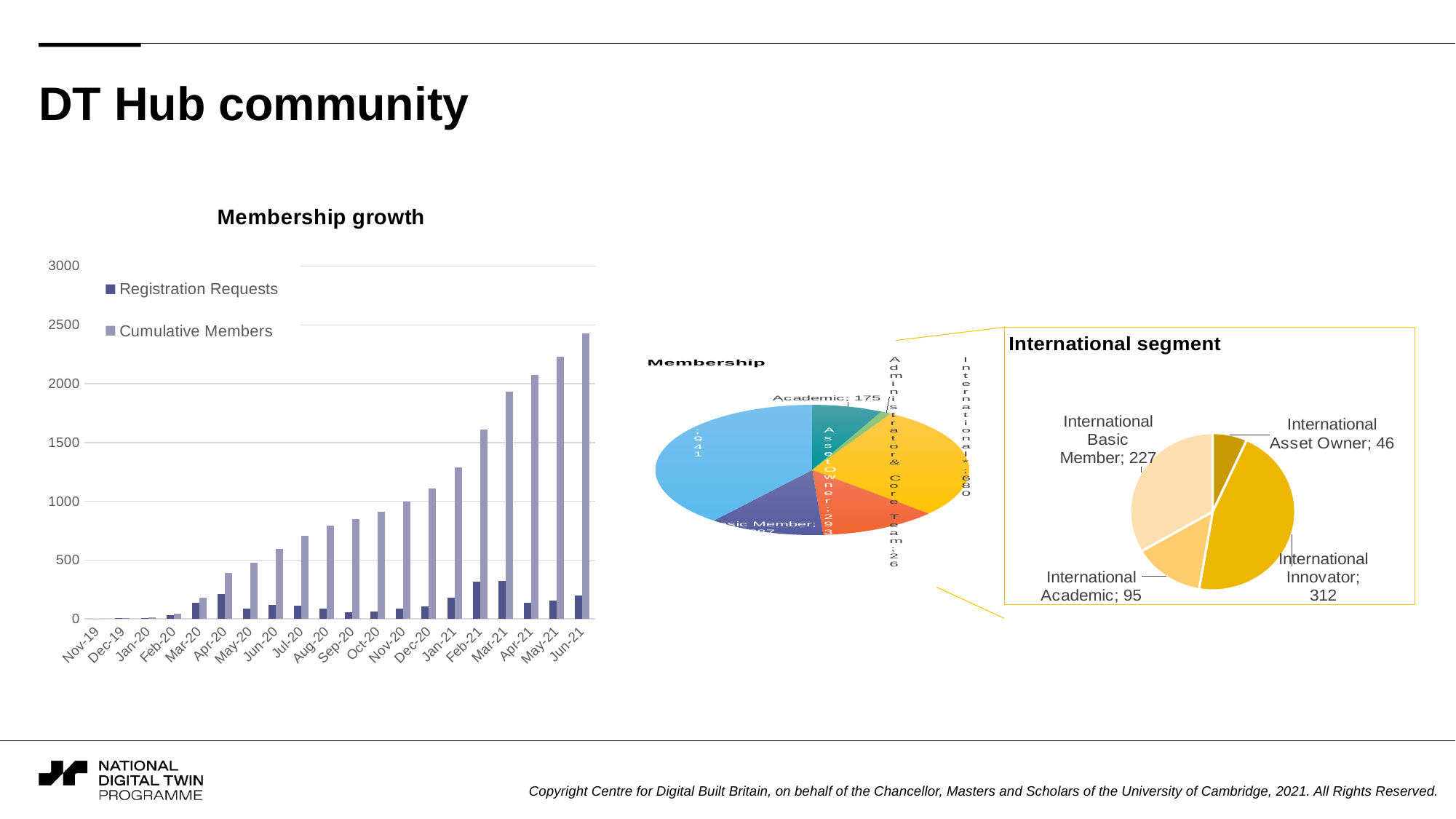
In the 'Membership growth' chart, is the Cumulative Members value for Jun-21 greater or less than 2000? greater How many series does the legend of the 'Membership growth' chart list? 2 In the 'International segment' pie chart, which category has the highest value? International Innovator What kind of chart is the 'Membership growth' chart? bar chart In the 'Membership' pie chart, what is the value for International*? 680 In the 'International segment' pie chart, what is the value for International Academic? 95 In the 'Membership' pie chart, what is the value for Academic? 175 In the 'International segment' pie chart, what is the difference between International Innovator and International Basic Member? 85 In the 'Membership growth' chart, do the Cumulative Members values rise or fall from Nov-19 to Jun-21? rise In the 'Membership' pie chart, which is larger, Academic or Asset Owner? Asset Owner How many months are shown on the x axis of the 'Membership growth' chart? 20 In the 'International segment' pie chart, which category has the lowest value? International Asset Owner